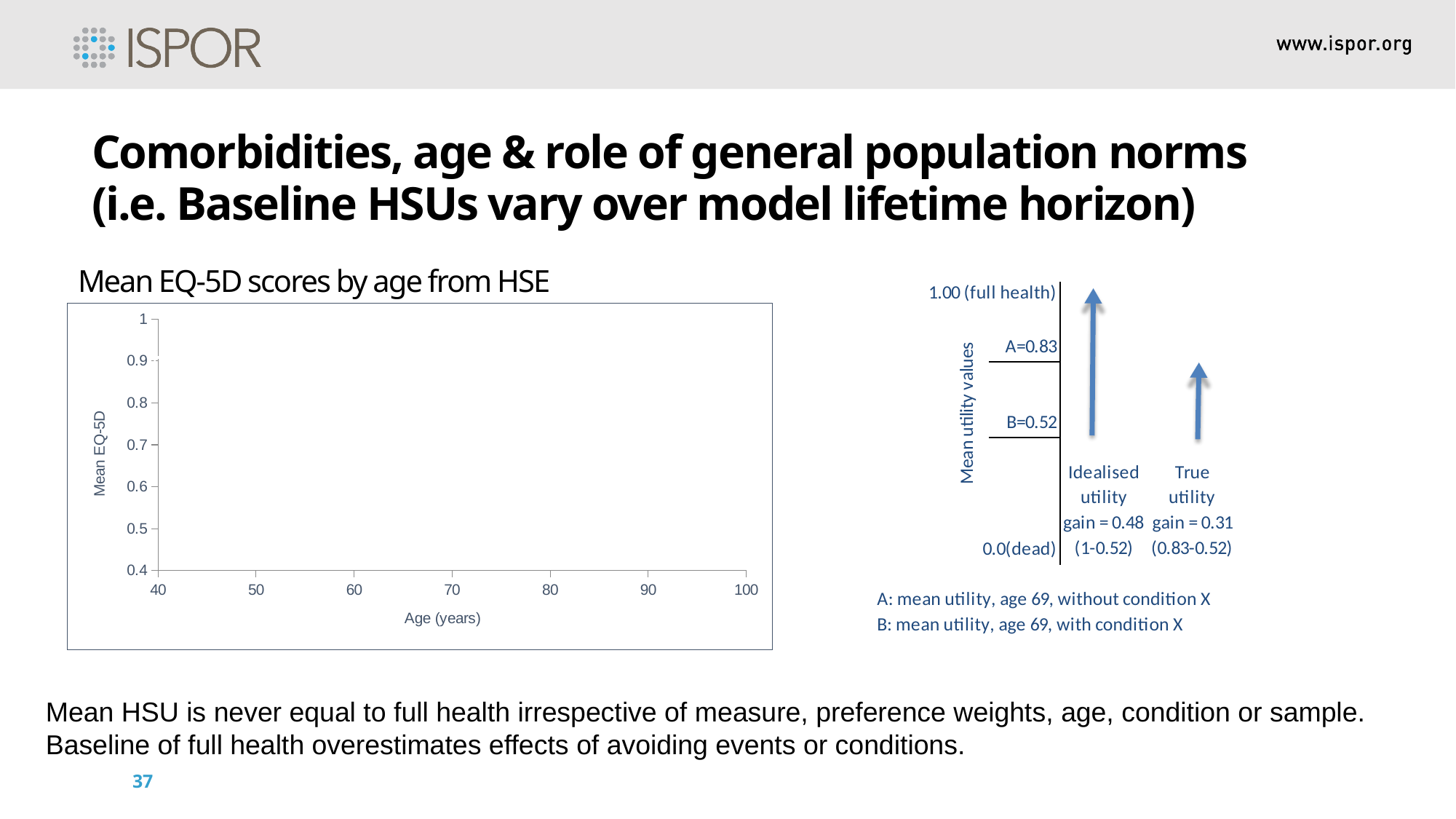
In the diagram on the right of the slide, what value is labelled as full health? 1.00 In the diagram on the right of the slide, what is the difference between A and B? 0.31 In the diagram on the right of the slide, what is the value of B (mean utility, age 69, with condition X)? 0.52 In the diagram on the right of the slide, which is larger, the idealised utility gain or the true utility gain? Idealised utility gain In the diagram on the right of the slide, what is the idealised utility gain? 0.48 In the diagram on the right of the slide, what is the value of A (mean utility, age 69, without condition X)? 0.83 In the diagram on the right of the slide, which is larger, A or B? A What is the y-axis label of the left chart, 'Mean EQ-5D scores by age from HSE'? Mean EQ-5D In the diagram on the right of the slide, what is the true utility gain? 0.31 What is the title of the chart on the left of the slide? Mean EQ-5D scores by age from HSE